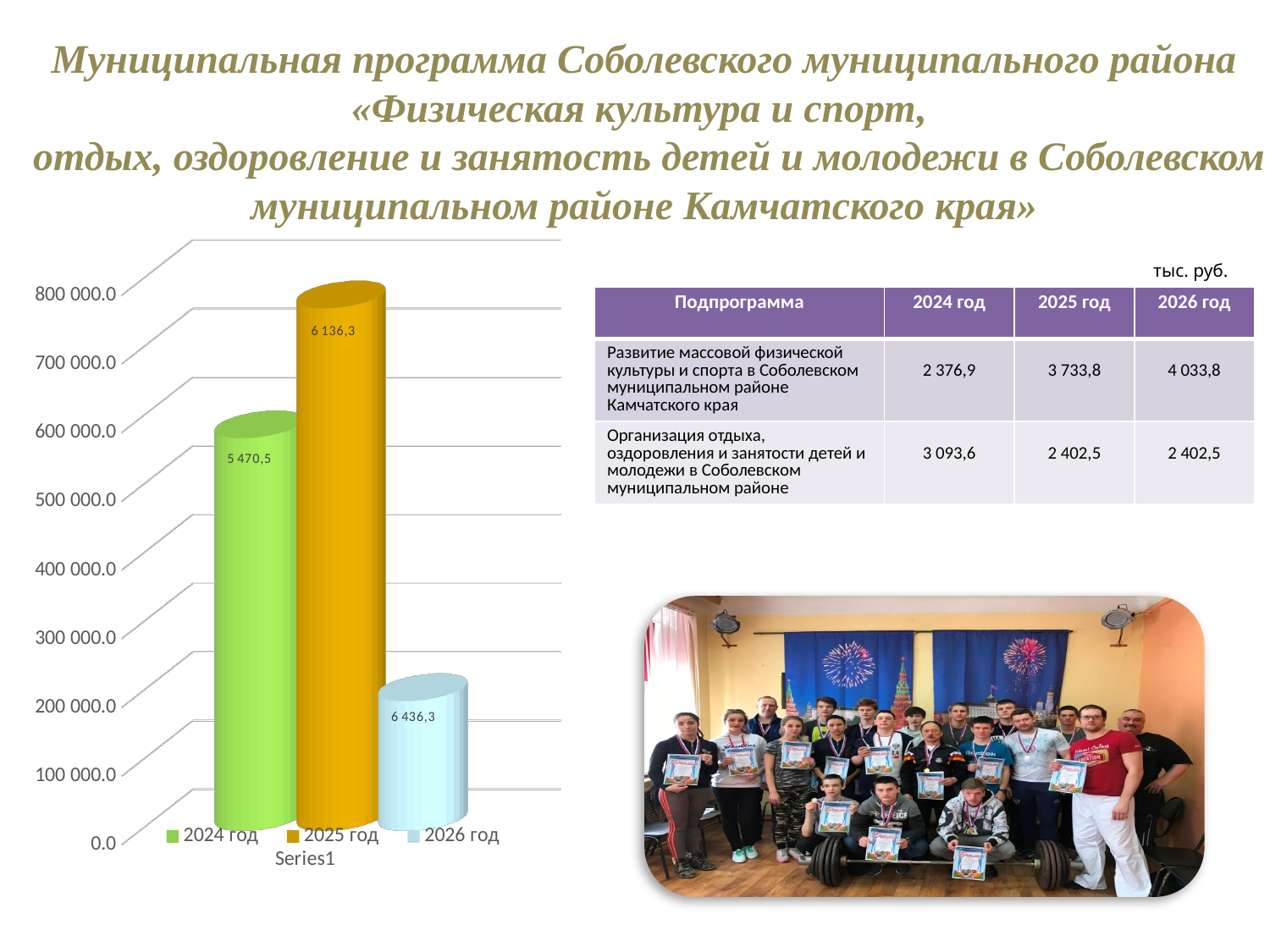
How many series does the chart legend list? 3 What is the difference between the data labels for 2025 год and 2024 год? 665,8 What is the label on the category axis of the chart? Series1 What kind of chart is shown on the slide? bar chart What is the data label on the bar for 2025 год? 6 136,3 Is the bar for 2024 год plotted greater or less than 500 000.0 on the axis? greater What is the difference between the data labels for 2026 год and 2025 год? 300,0 What is the data label on the bar for 2026 год? 6 436,3 Is the bar for 2025 год plotted greater or less than 700 000.0 on the axis? greater What is the data label on the bar for 2024 год? 5 470,5 Is the bar for 2026 год plotted greater or less than 300 000.0 on the axis? less What colour is the bar for 2025 год? orange